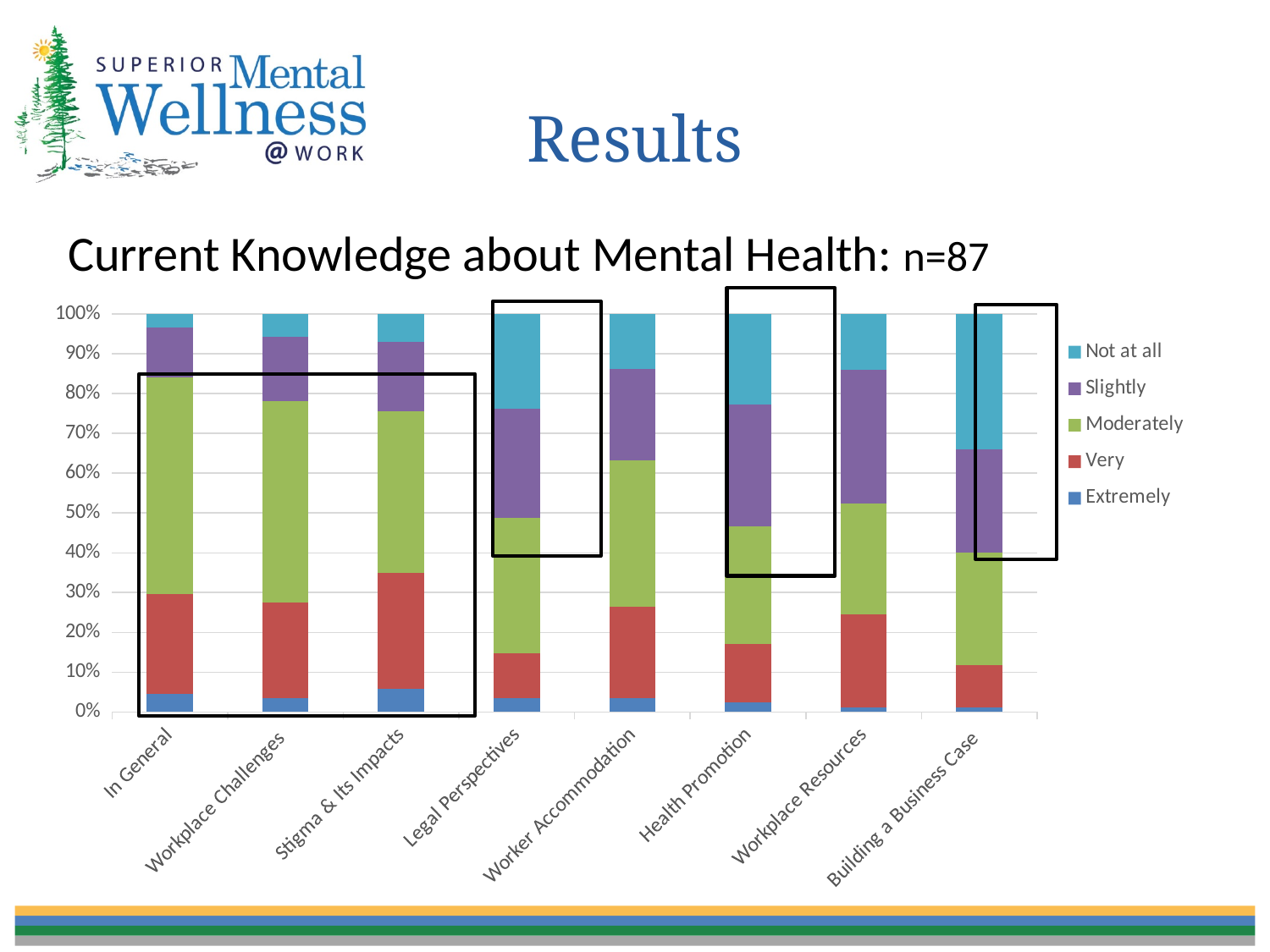
Which series is shown at the bottom of each stacked bar? Extremely Is the 'Not at all' segment larger for Legal Perspectives or for Worker Accommodation? Legal Perspectives How many categories are shown along the x axis of the chart? 8 What sample size (n) is stated in the chart's title? n=87 Is the combined share of Extremely, Very and Moderately for Building a Business Case greater or less than 50%? less Which category has the largest 'Not at all' segment? Building a Business Case What kind of chart is shown on the slide? Stacked bar chart Is the 'Not at all' share for Building a Business Case greater or less than 30%? greater How many series does the chart's legend list? 5 Is the combined share of Extremely, Very and Moderately for In General greater or less than 80%? greater Which category has the largest 'Very' segment? Stigma & Its Impacts Is the 'Moderately' segment larger for In General or for Building a Business Case? In General